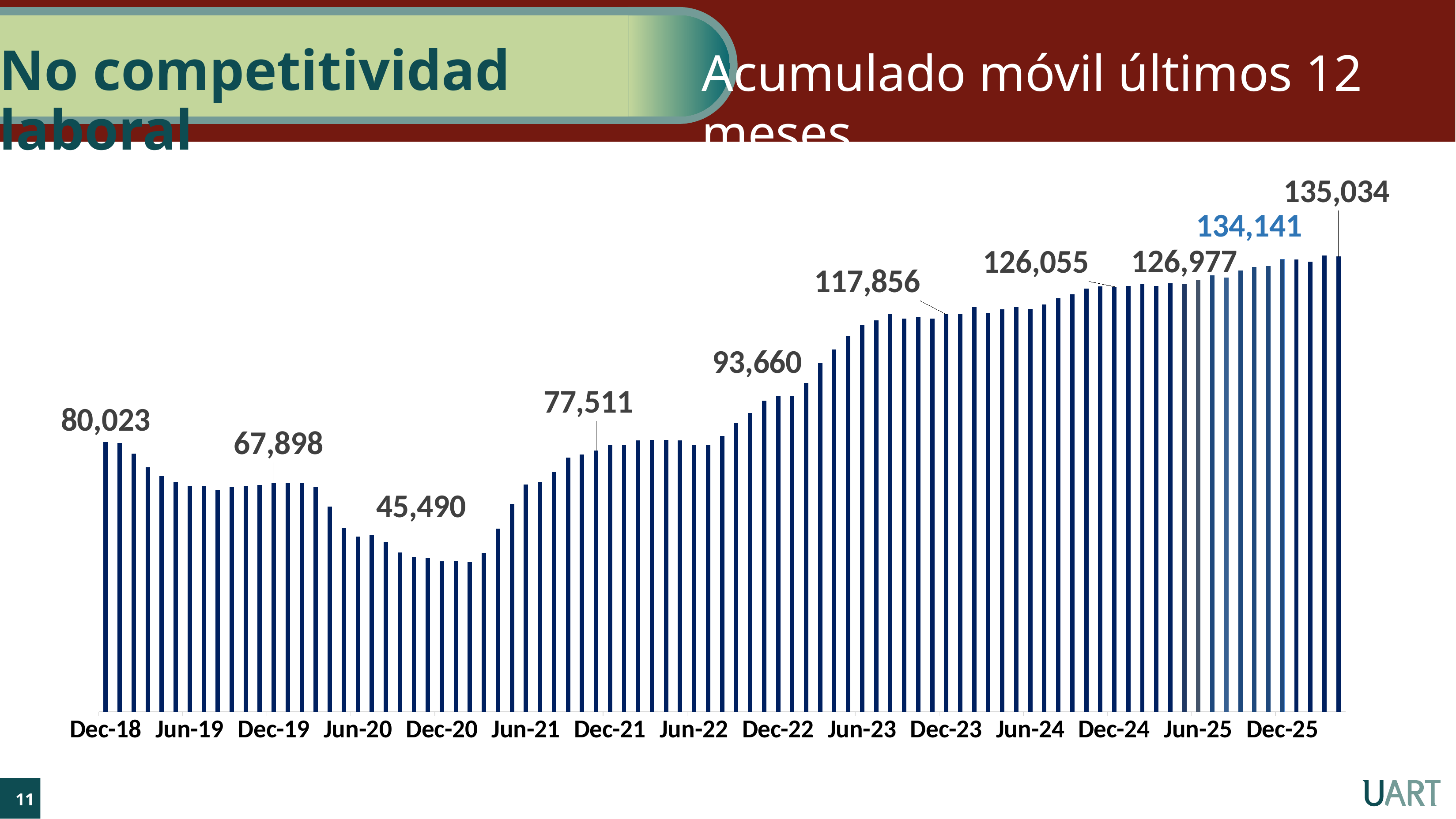
Do the values rise or fall from Dec-20 to Dec-25? Rise What kind of chart is shown on the slide? Bar chart What is the value for Dec-23? 117,856 What is the value for Dec-19? 67,898 Which is larger, the value for Dec-19 or the value for Dec-21? Dec-21 What is the value for Dec-18? 80,023 What is the value for Dec-25? 134,141 Which of the labelled values is the lowest? 45,490 What is the value labelled on the last (rightmost) bar? 135,034